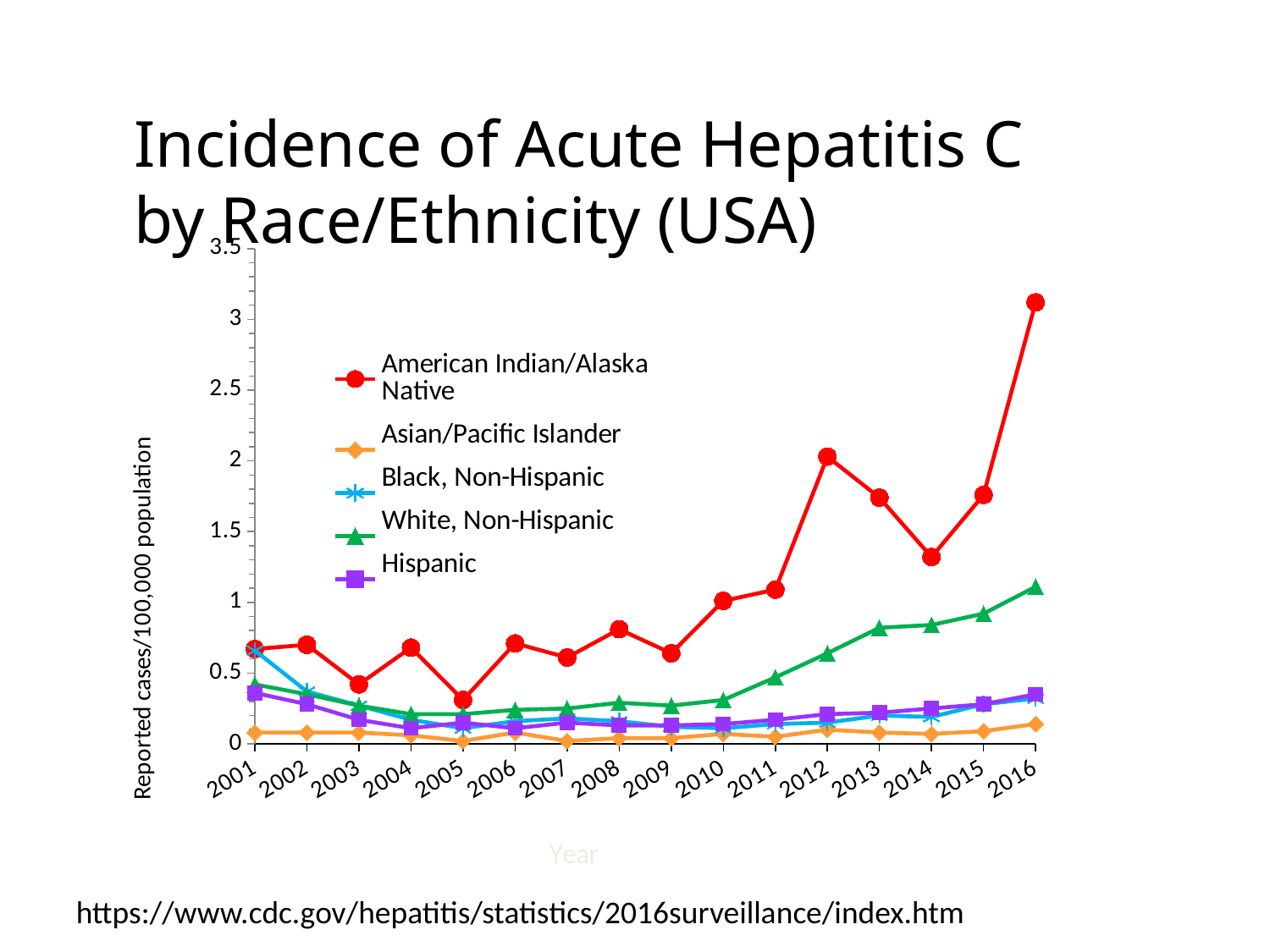
Which race/ethnicity group has the highest incidence in 2016? American Indian/Alaska Native What kind of chart is shown on the slide? line chart Does the White, Non-Hispanic series rise or fall from 2011 to 2016? rise Which race/ethnicity group has the lowest incidence in 2016? Asian/Pacific Islander Which is larger in 2012, the value for American Indian/Alaska Native or the value for Hispanic? American Indian/Alaska Native How many years are plotted along the x axis? 16 Is the value for Asian/Pacific Islander in 2016 greater or less than 0.5? less What is the label on the y axis? Reported cases/100,000 population In which year does the American Indian/Alaska Native series reach its highest value? 2016 Is the value for American Indian/Alaska Native in 2012 greater or less than 1.5? greater Is the value for American Indian/Alaska Native in 2016 greater or less than 2.5? greater How many series does the legend list? 5